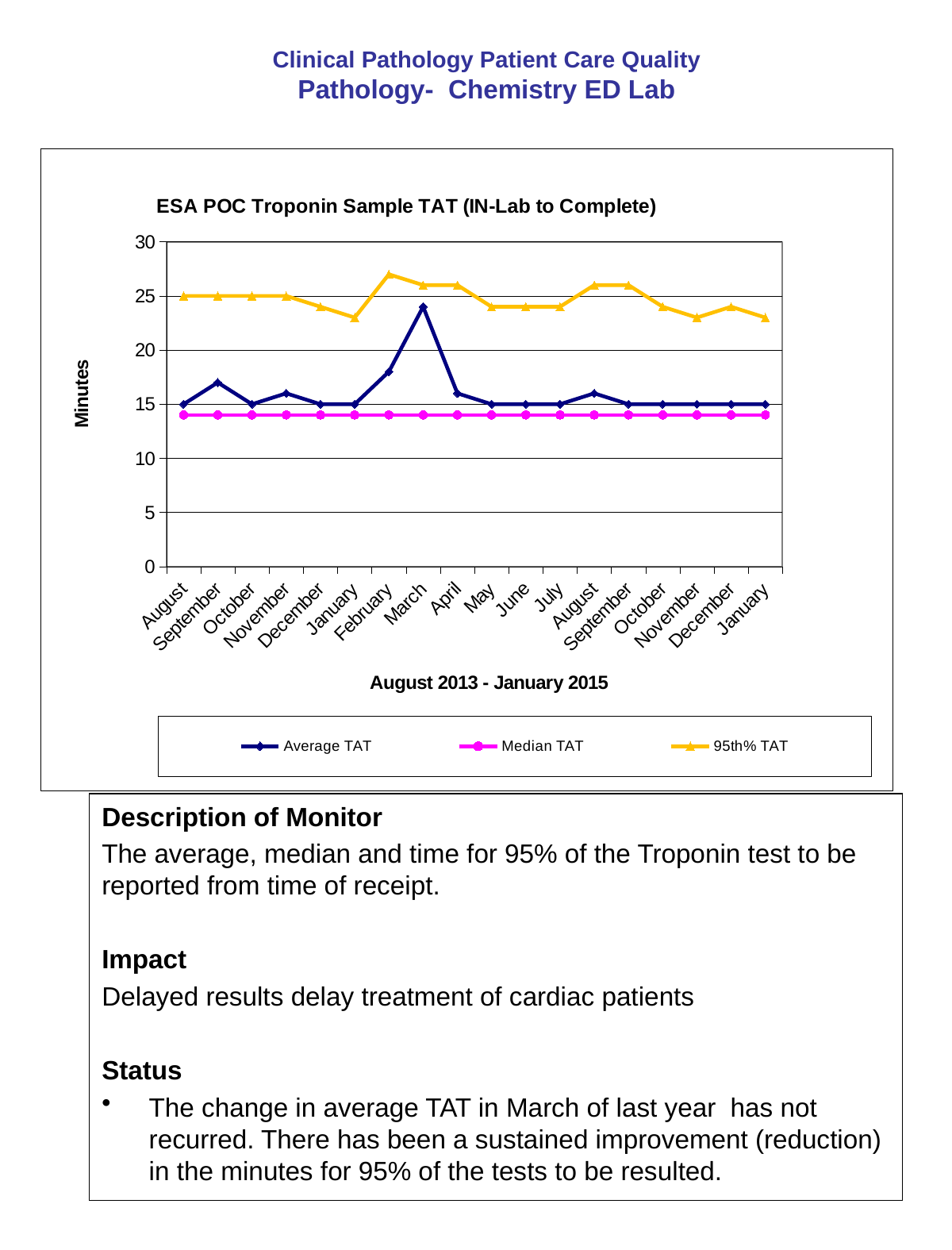
What is the Average TAT for the first August shown? 15 How many months are plotted along the x axis? 18 What kind of chart is shown on the slide? line chart What is the 95th% TAT for the first August shown? 25 How many series does the legend list? 3 In which month does the Average TAT reach its highest value? March Which is larger, the Average TAT in March or the Average TAT in the first September? March What is the label on the y axis? Minutes Is the Average TAT in March greater or less than 20? greater What is the title of the chart? ESA POC Troponin Sample TAT (IN-Lab to Complete) In which month does the 95th% TAT reach its highest value? February Is the Median TAT in August greater or less than 15? less